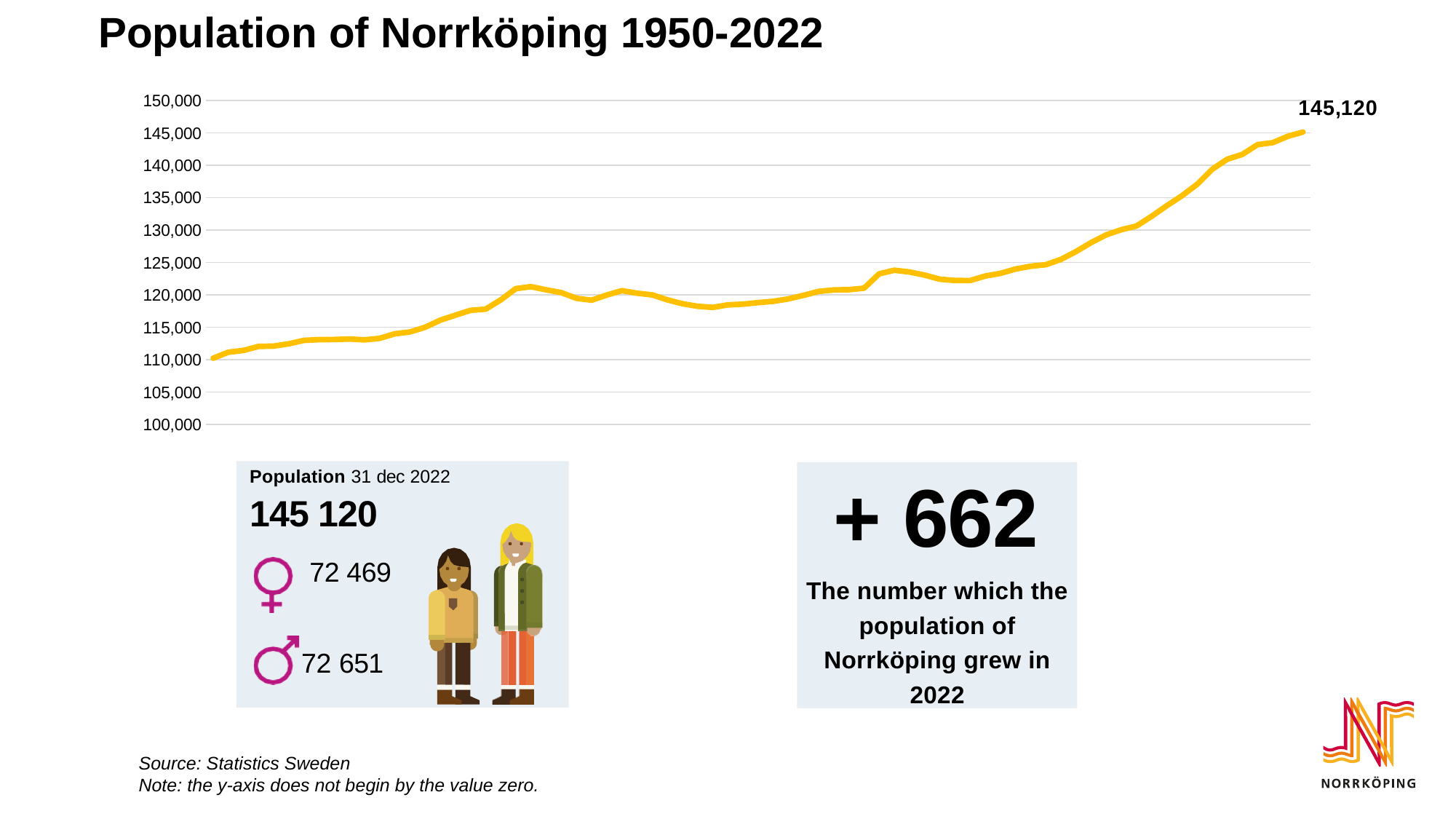
What is the lowest value shown on the y-axis of the chart? 100,000 How many lines (series) are plotted on the chart? 1 Is the lowest point of the line at the start or at the end of the series? start Is the value at the end of the line (2022) greater or less than 140,000? greater Is the population value at the start of the line (1950) greater or less than 115,000? less What kind of chart is shown on the slide? line chart Is the highest point of the line at the start or at the end of the series? end Does the population of Norrköping generally rise or fall from 1950 to 2022? rise What is the population value labelled at the end of the line (2022)? 145,120 Is the population value at the start of the line (1950) greater or less than 105,000? greater What is the title of the chart? Population of Norrköping 1950-2022